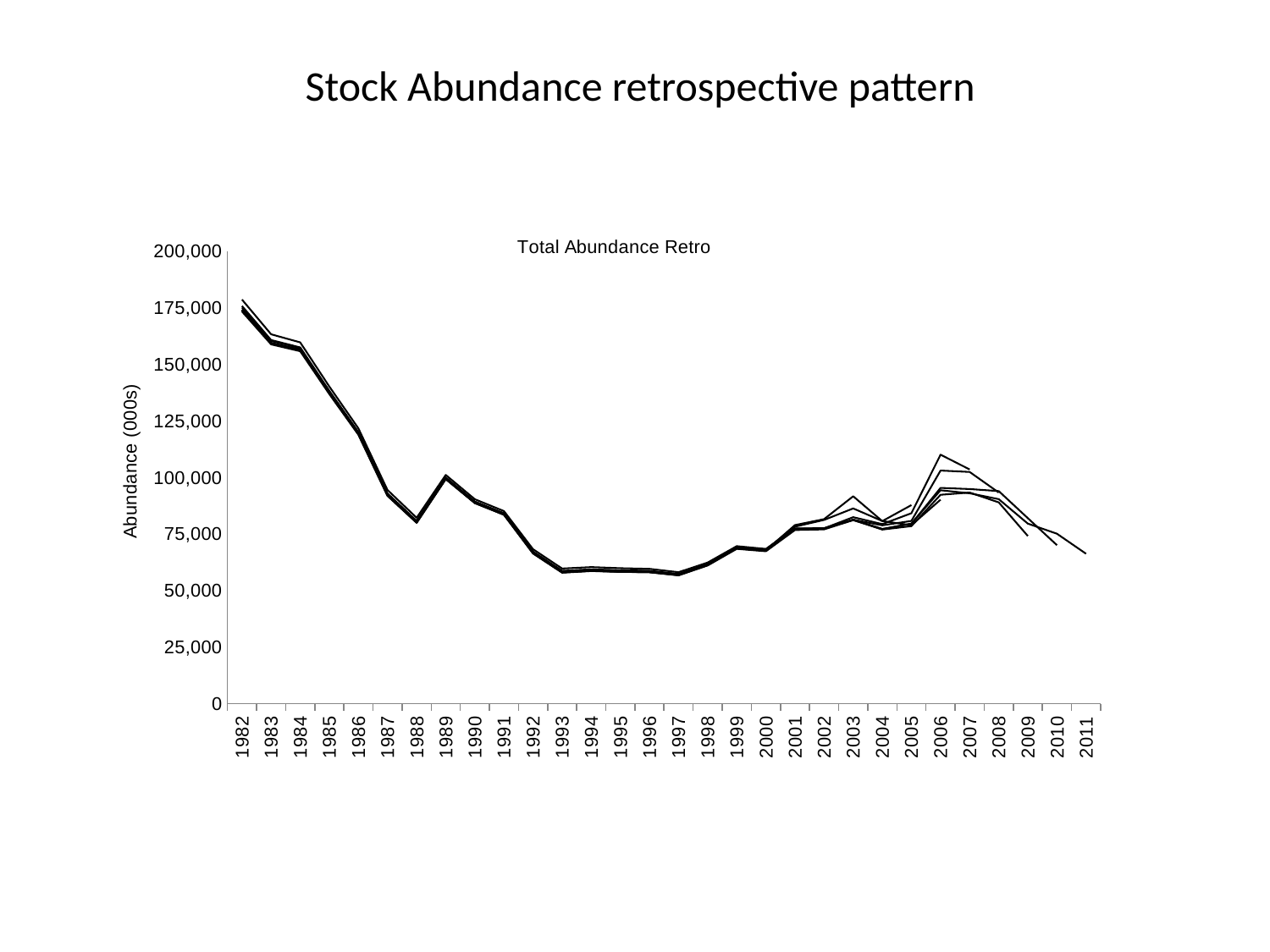
What is the label on the vertical axis of the chart? Abundance (000s) What is the title printed inside the chart area? Total Abundance Retro Which year has the highest abundance in the chart? 1982 Is the abundance value for 1982 greater or less than 150,000? greater Which year has the larger abundance, 1988 or 1989? 1989 What kind of chart is shown on the slide? line chart Is the abundance value for 1989 greater or less than 75,000? greater Is the abundance value for 1997 greater or less than 75,000? less How many years are labelled along the x axis of the chart? 30 Do the abundance values rise or fall from 2007 to 2011? fall Do the abundance values rise or fall from 1982 to 1988? fall